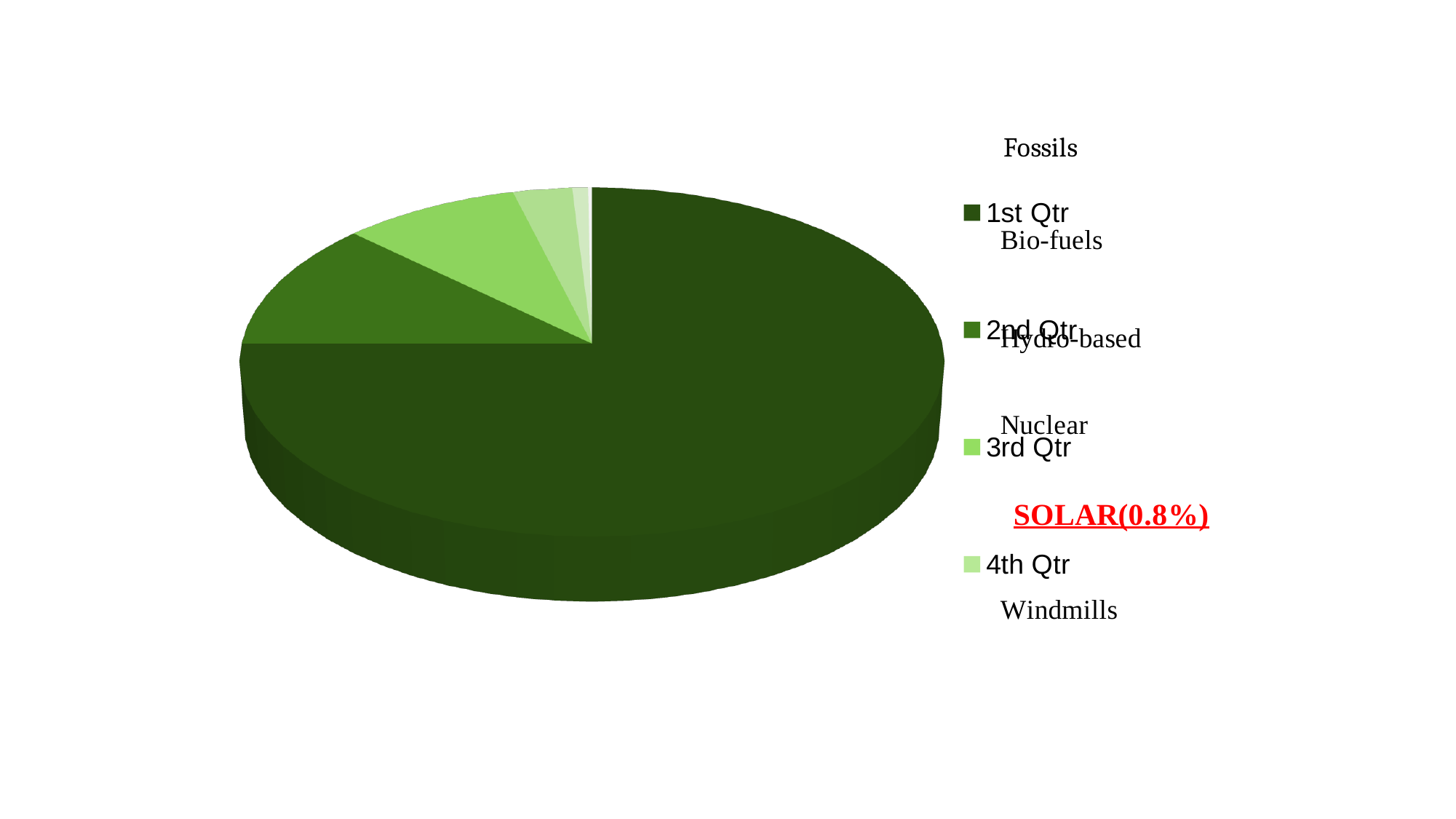
Does the 1st Qtr slice take up more or less than half of the pie? more What kind of chart is shown on the slide? pie chart Which legend category has the largest slice of the pie? 1st Qtr What is the first entry listed in the legend? 1st Qtr Which slice is larger, 1st Qtr or 2nd Qtr? 1st Qtr How many entries does the legend list? 4 What percentage is written next to SOLAR in the red text on the slide? 0.8% Which slice is larger, 2nd Qtr or 3rd Qtr? 2nd Qtr